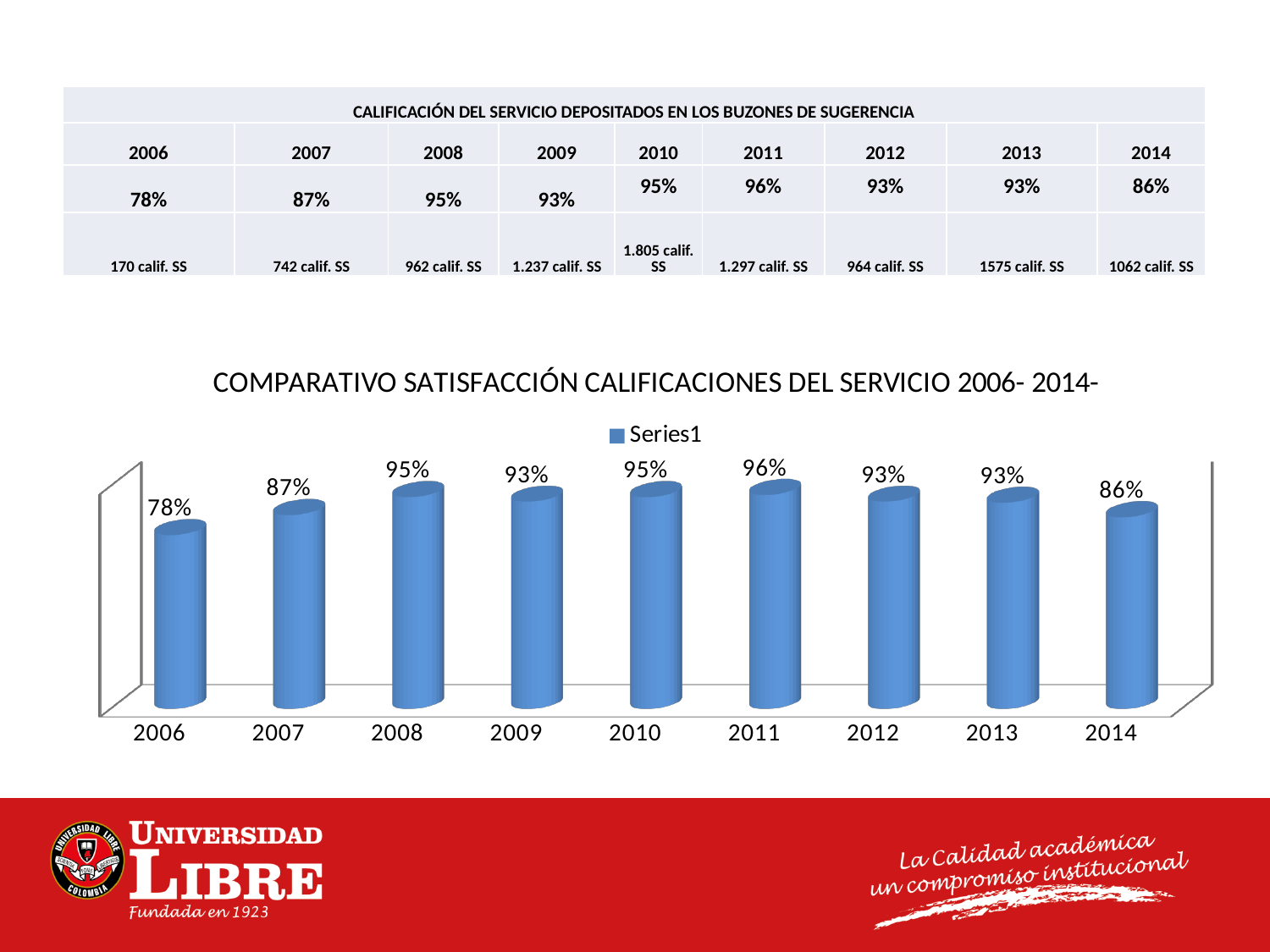
What is the difference between the values for 2011 and 2006? 18% How many series does the legend list? 1 What is the difference between the values for 2008 and 2014? 9% What kind of chart is shown? bar chart Which year has the lowest value? 2006 Which is larger, the value for 2007 or the value for 2013? 2013 Which year has the highest value? 2011 What is the value for 2011? 96% How many years are shown on the x axis? 9 What is the title of the chart? COMPARATIVO SATISFACCIÓN CALIFICACIONES DEL SERVICIO 2006- 2014- What is the value for 2006? 78% What is the value for 2014? 86%